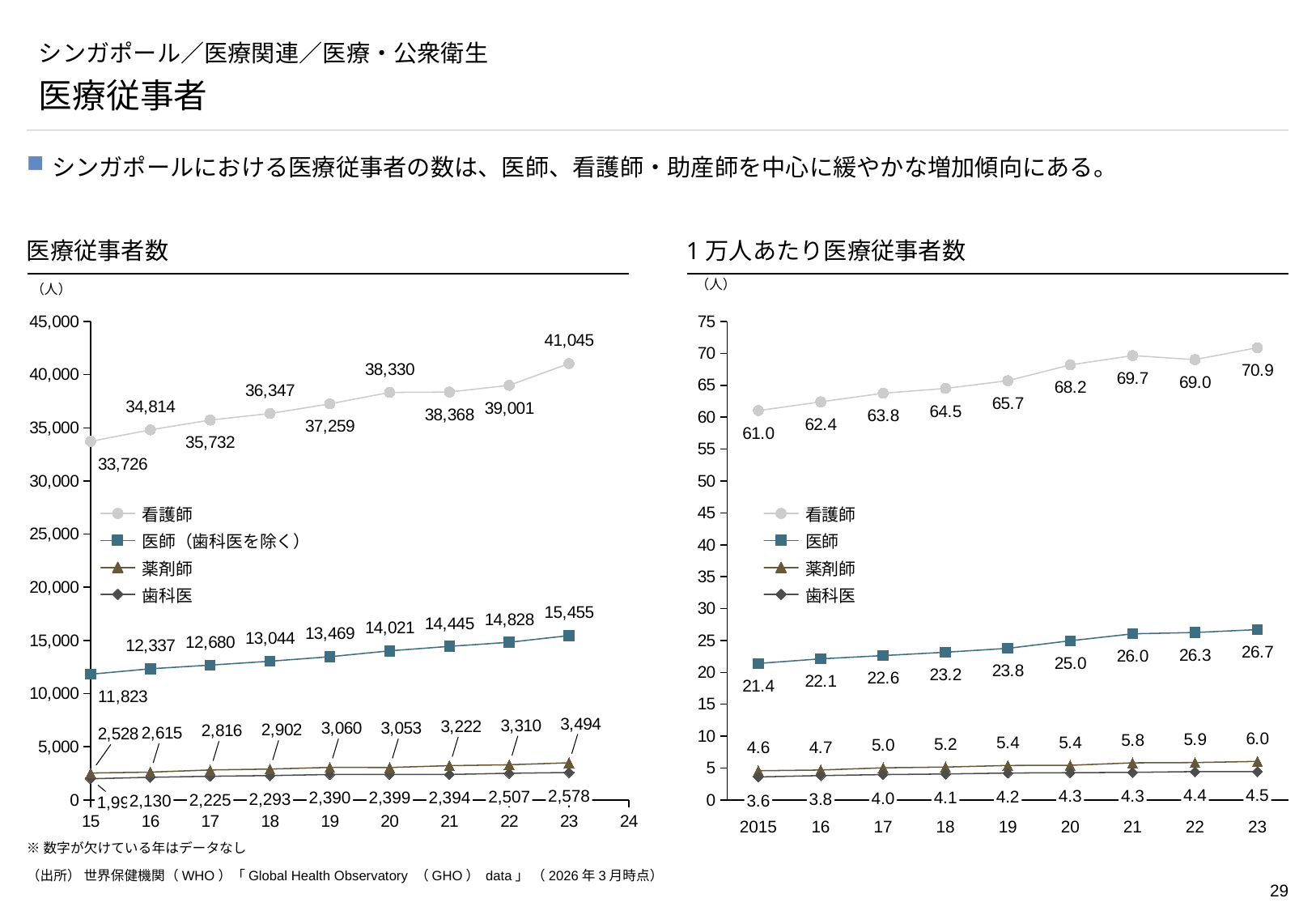
In the left chart (医療従事者数), what is the difference between the 看護師 values in 23 and 22? 2,044 In the left chart (医療従事者数), what is the value for 医師（歯科医を除く） in 15? 11,823 In the left chart (医療従事者数), which series has the highest values? 看護師 In the right chart (1万人あたり医療従事者数), what is the value for 医師 in 23? 26.7 In the right chart (1万人あたり医療従事者数), what is the value for 看護師 in 2015? 61.0 In the right chart (1万人あたり医療従事者数), is the 看護師 value in 22 larger or smaller than in 21? smaller In the right chart (1万人あたり医療従事者数), what is the value for 歯科医 in 19? 4.2 What kind of chart is the right chart (1万人あたり医療従事者数)? line chart In the left chart (医療従事者数), what is the value for 薬剤師 in 20? 3,053 In the left chart (医療従事者数), what is the value for 看護師 in 23? 41,045 In the right chart (1万人あたり医療従事者数), what is the overall trend of the 医師 series from 2015 to 23? rising In the left chart (医療従事者数), how many series does the legend list? 4